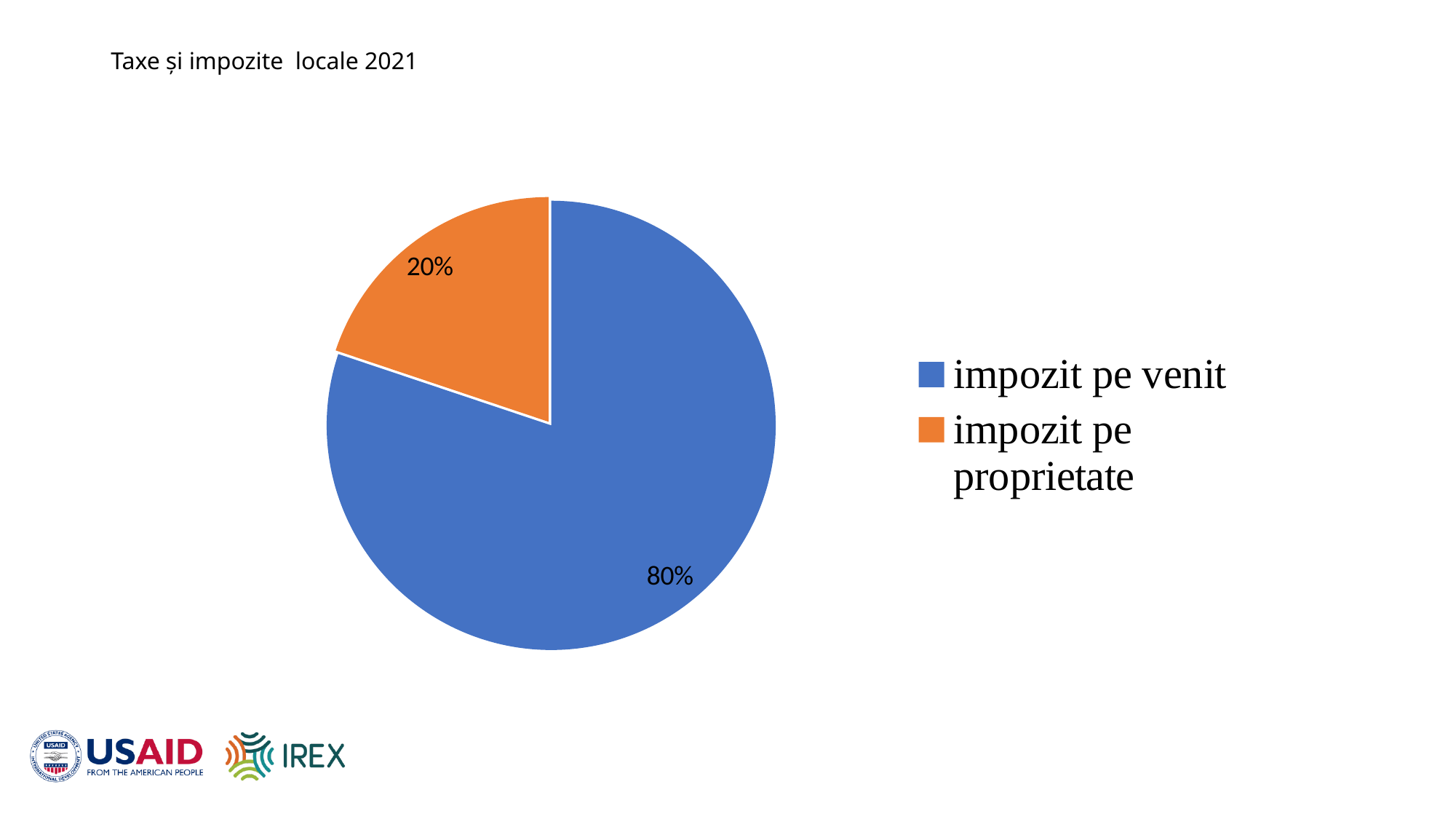
What is the difference in percentage points between the "impozit pe venit" and "impozit pe proprietate" slices? 60 Which is larger, the slice for "impozit pe venit" or the slice for "impozit pe proprietate"? impozit pe venit Which category has the smallest slice of the pie? impozit pe proprietate What kind of chart is shown on the slide? pie chart How many categories are shown in the pie chart? 2 How many entries does the legend list? 2 What is the title shown at the top of the slide? Taxe și impozite locale 2021 What share of the pie does "impozit pe proprietate" represent? 20% What share of the pie does "impozit pe venit" represent? 80% What colour is the slice for "impozit pe proprietate"? orange Which category has the largest slice of the pie? impozit pe venit